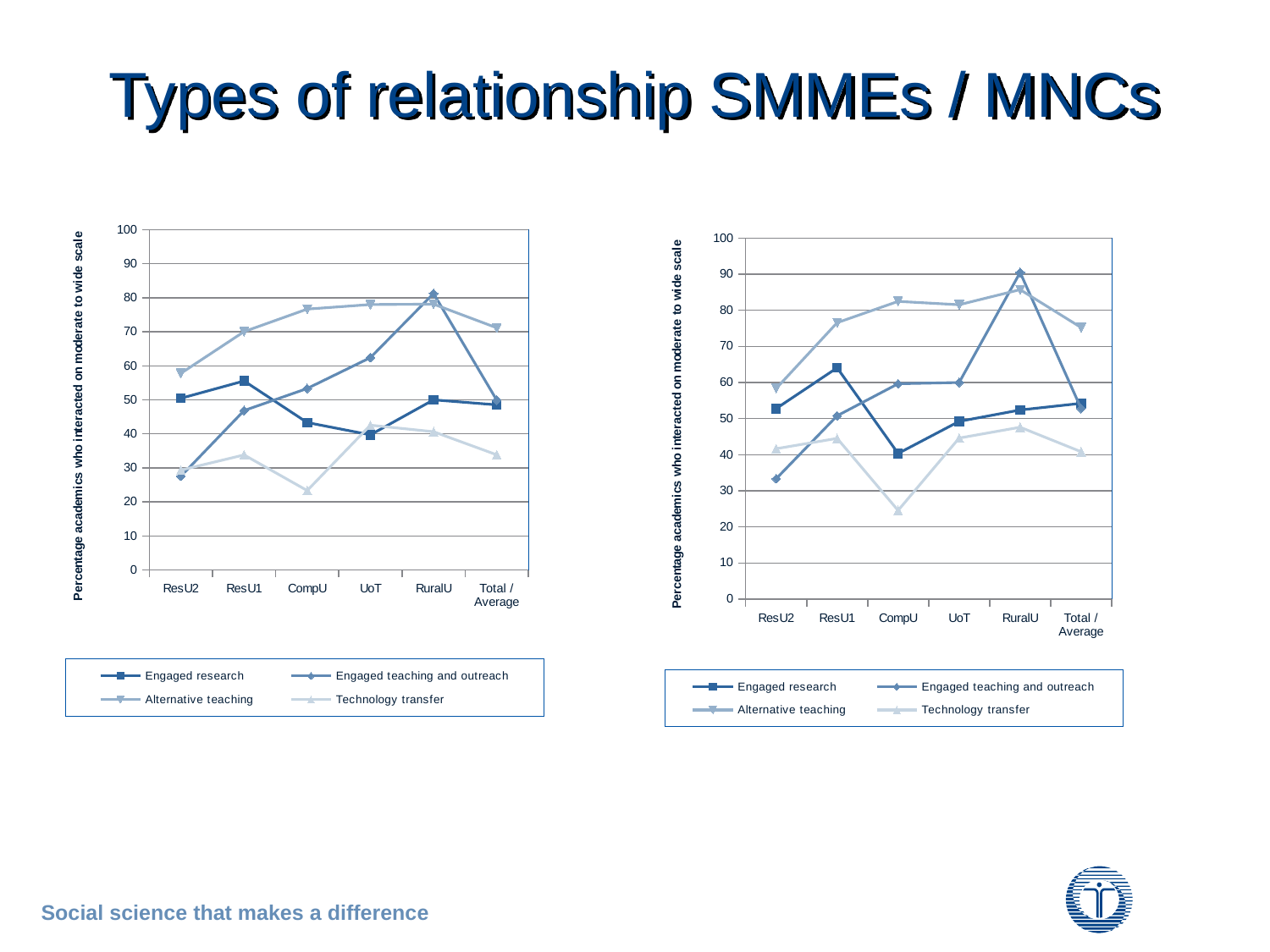
In the chart on the right, which is larger at ResU1: Alternative teaching or Engaged research? Alternative teaching In the chart on the left, how many series does the legend list? 4 In the chart on the left, does the Engaged teaching and outreach line rise or fall from ResU2 to RuralU? Rises What kind of chart is the chart on the left of the slide? Line chart In the chart on the left, is the value for Alternative teaching at UoT greater or less than 70? greater In the chart on the left, is the value for Technology transfer at CompU greater or less than 30? less In the chart on the left, how many categories are shown on the x axis? 6 In the chart on the right, is the value for Engaged teaching and outreach at RuralU greater or less than 80? greater What is the y-axis label of the chart on the right? Percentage academics who interacted on moderate to wide scale In the chart on the right, at which category is Technology transfer lowest? CompU In the chart on the left, which series has the lowest value at RuralU? Technology transfer